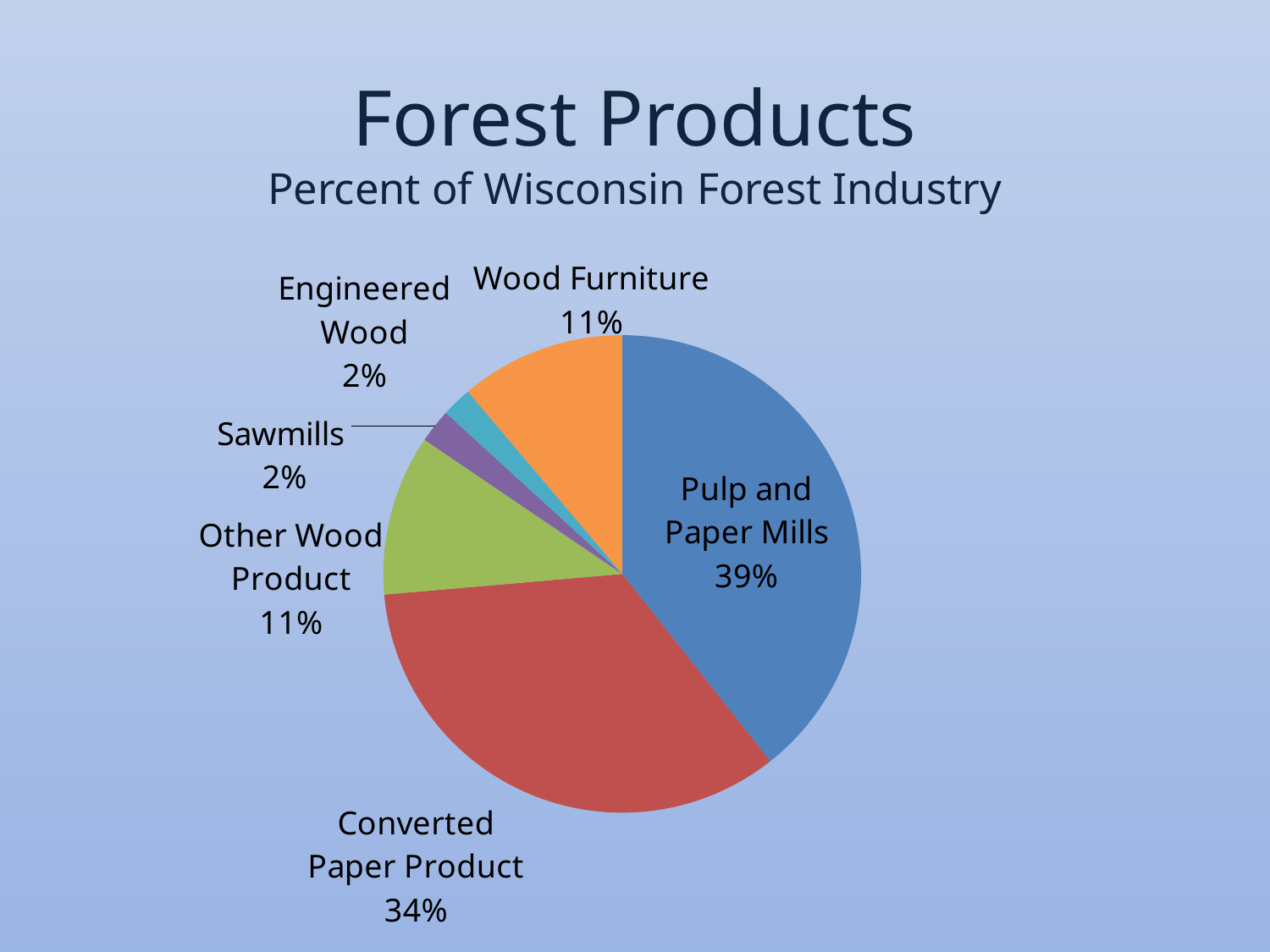
How many categories are shown in the pie chart? 6 What is the combined share of Pulp and Paper Mills and Converted Paper Product? 73% Which category has the largest share of the pie? Pulp and Paper Mills What is the difference in percentage points between Pulp and Paper Mills and Converted Paper Product? 5 What percentage of the Wisconsin forest industry is Pulp and Paper Mills? 39% What percentage is shown for Converted Paper Product? 34% What percentage is shown for Wood Furniture? 11% What is the subtitle of the chart? Percent of Wisconsin Forest Industry What is the difference in percentage points between Converted Paper Product and Other Wood Product? 23 What percentage is shown for Sawmills? 2% What kind of chart is shown on the slide? Pie chart Which is larger, the share for Wood Furniture or the share for Engineered Wood? Wood Furniture